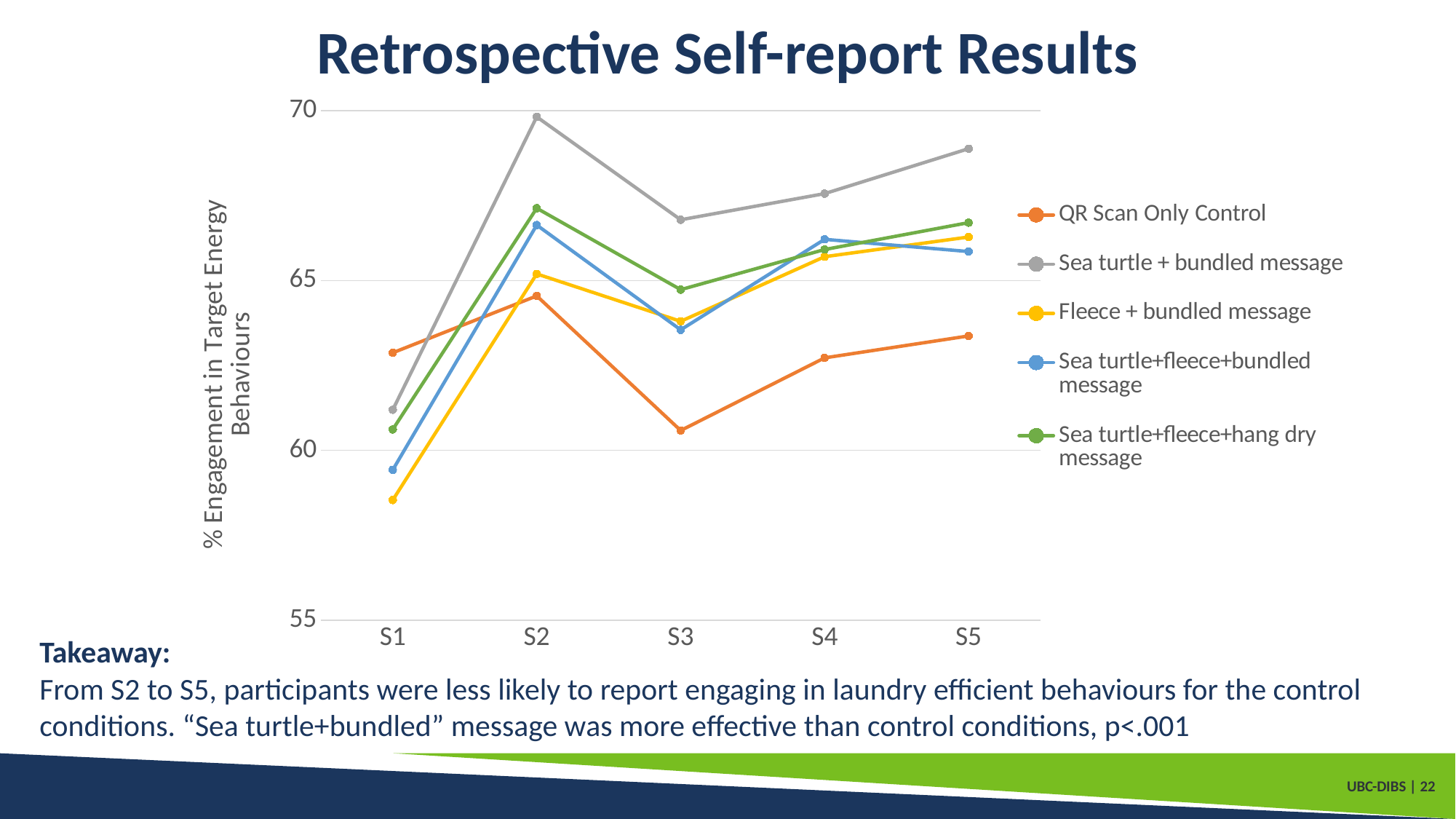
Which series has the lowest value at S5? QR Scan Only Control Is the value for Fleece + bundled message at S1 greater or less than 60? less Which series has the lowest value at S1? Fleece + bundled message How many series does the legend list? 5 What kind of chart is shown on the slide? line chart What is the label on the y axis? % Engagement in Target Energy Behaviours Which series has the highest value at S2? Sea turtle + bundled message At S5, which is larger: Sea turtle + bundled message or QR Scan Only Control? Sea turtle + bundled message Is the value for Sea turtle + bundled message at S2 greater or less than 65? greater Does the QR Scan Only Control line rise or fall from S3 to S5? rise How many categories are shown on the x axis? 5 Is the value for QR Scan Only Control at S2 greater or less than 65? less